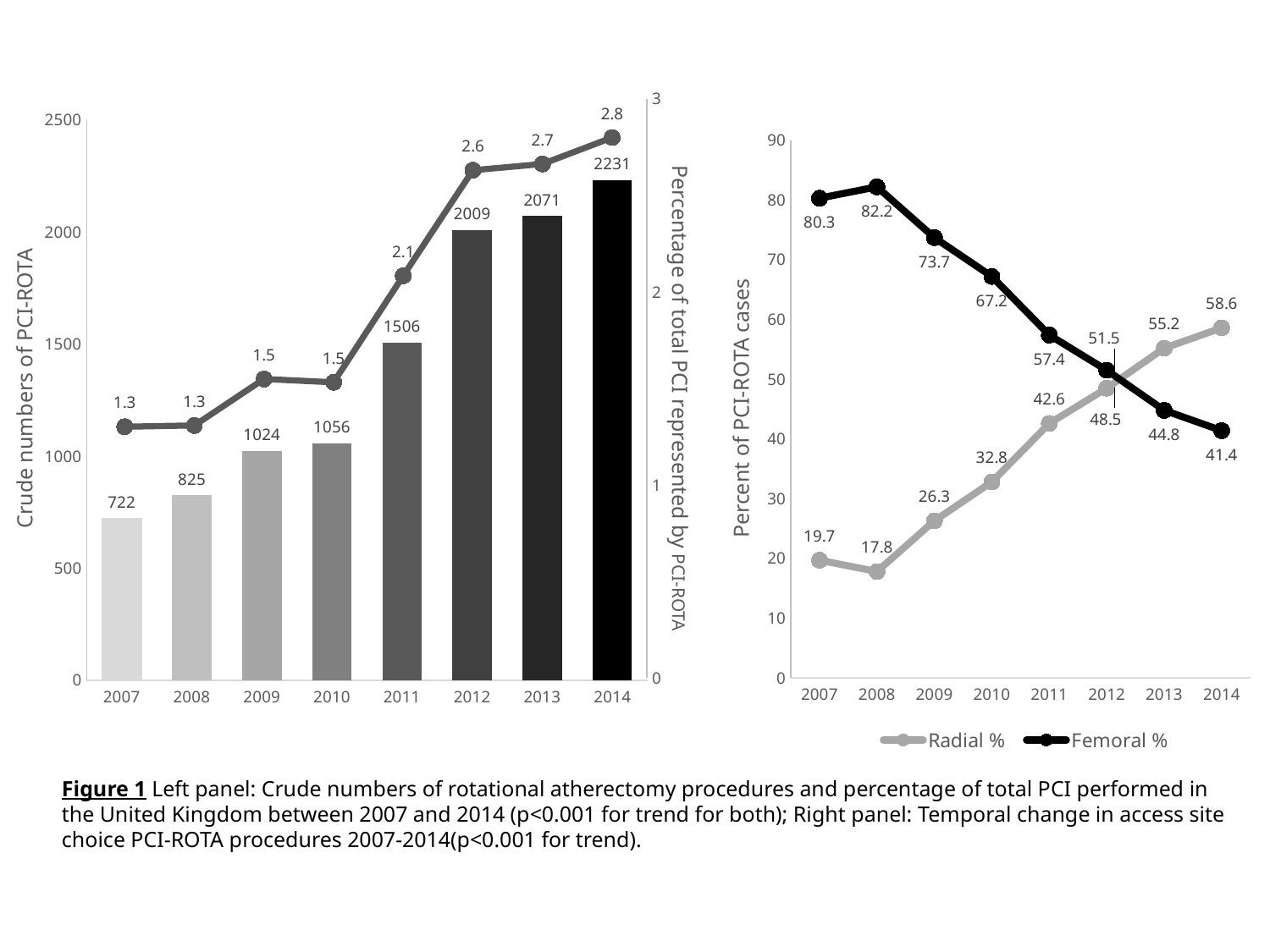
In the right panel chart, does the Femoral % rise or fall from 2007 to 2014? fall In the left panel chart, which year has the highest crude number of PCI-ROTA procedures? 2014 In the left panel chart, what is the crude number of PCI-ROTA procedures in 2011? 1506 In the left panel chart, do the crude numbers of PCI-ROTA rise or fall from 2007 to 2014? rise In the right panel chart, what is the Femoral % value in 2010? 67.2 In the right panel chart, which is larger in 2013, Radial % or Femoral %? Radial % In the left panel chart, what is the difference in crude numbers of PCI-ROTA between 2014 and 2007? 1509 In the right panel chart, how many series does the legend list? 2 In the right panel chart, what is the Radial % value in 2008? 17.8 In the left panel chart, how many years are shown on the x axis? 8 In the left panel chart, which year has the lowest crude number of PCI-ROTA procedures? 2007 In the left panel chart, what percentage of total PCI was represented by PCI-ROTA in 2014? 2.8